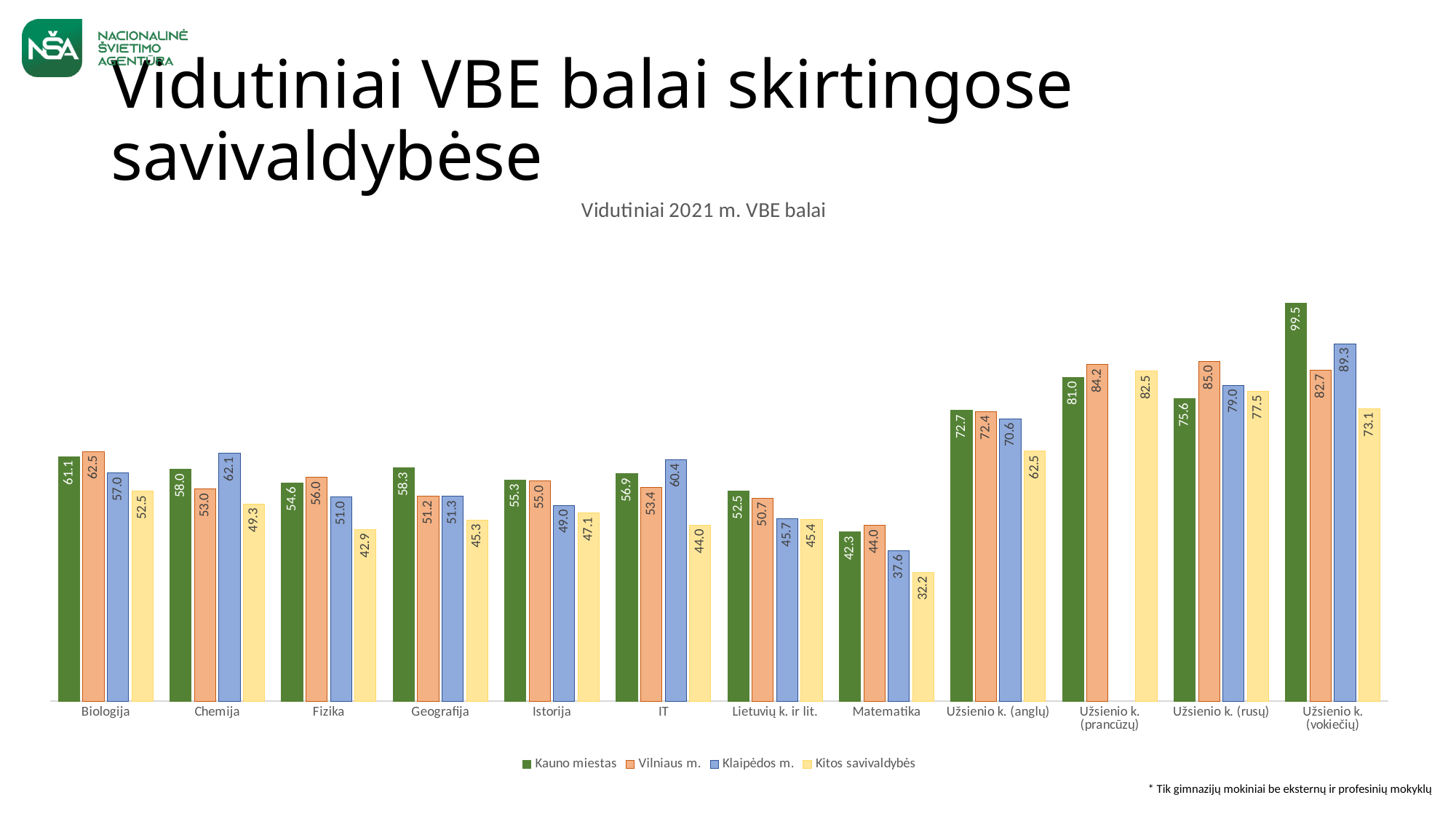
How many series does the legend list? 4 What is the title of the chart? Vidutiniai 2021 m. VBE balai What is the value for Kitos savivaldybės in Fizika? 42.9 What is the difference between the Kauno miestas and Vilniaus m. values in Užsienio k. (vokiečių)? 16.8 What kind of chart is shown on the slide? Bar chart Which is larger in Chemija: the value for Kauno miestas or for Klaipėdos m.? Klaipėdos m. What is the value for Klaipėdos m. in Užsienio k. (vokiečių)? 89.3 Which category has the highest value for Kauno miestas? Užsienio k. (vokiečių) How many subject categories are shown on the x axis? 12 What is the value for Kauno miestas in Matematika? 42.3 What is the value for Vilniaus m. in Užsienio k. (rusų)? 85.0 Which category has the lowest value for Kitos savivaldybės? Matematika